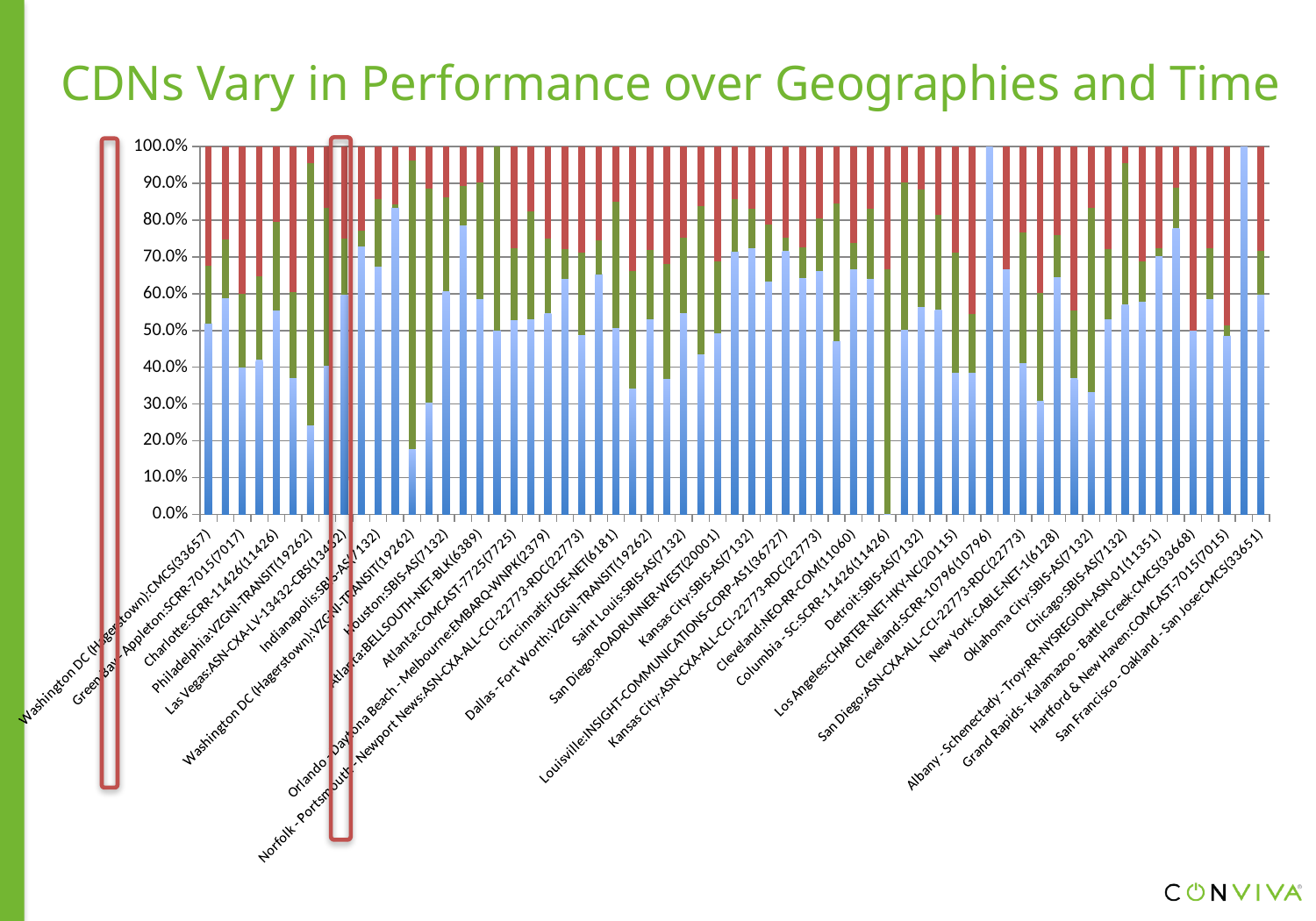
What is the highest value shown on the chart's vertical axis? 100.0% Is the blue segment of the last bar, San Francisco - Oakland - San Jose:CMCS(33651), greater or less than 50.0%? greater How many distinct colour segments make up each stacked bar in the chart? 3 What is the title of the slide containing the chart? CDNs Vary in Performance over Geographies and Time Which category label appears first (leftmost) on the horizontal axis? Washington DC (Hagerstown):CMCS(33657) What kind of chart is shown on the slide? Stacked bar chart Is the blue segment of the first bar, Washington DC (Hagerstown):CMCS(33657), greater or less than 40.0%? greater Does every stacked bar in the chart reach the same total height on the vertical axis? Yes, 100.0% What is the lowest value shown on the chart's vertical axis? 0.0% Which category label appears last (rightmost) on the horizontal axis? San Francisco - Oakland - San Jose:CMCS(33651) What is the interval between consecutive tick marks on the vertical axis? 10.0%